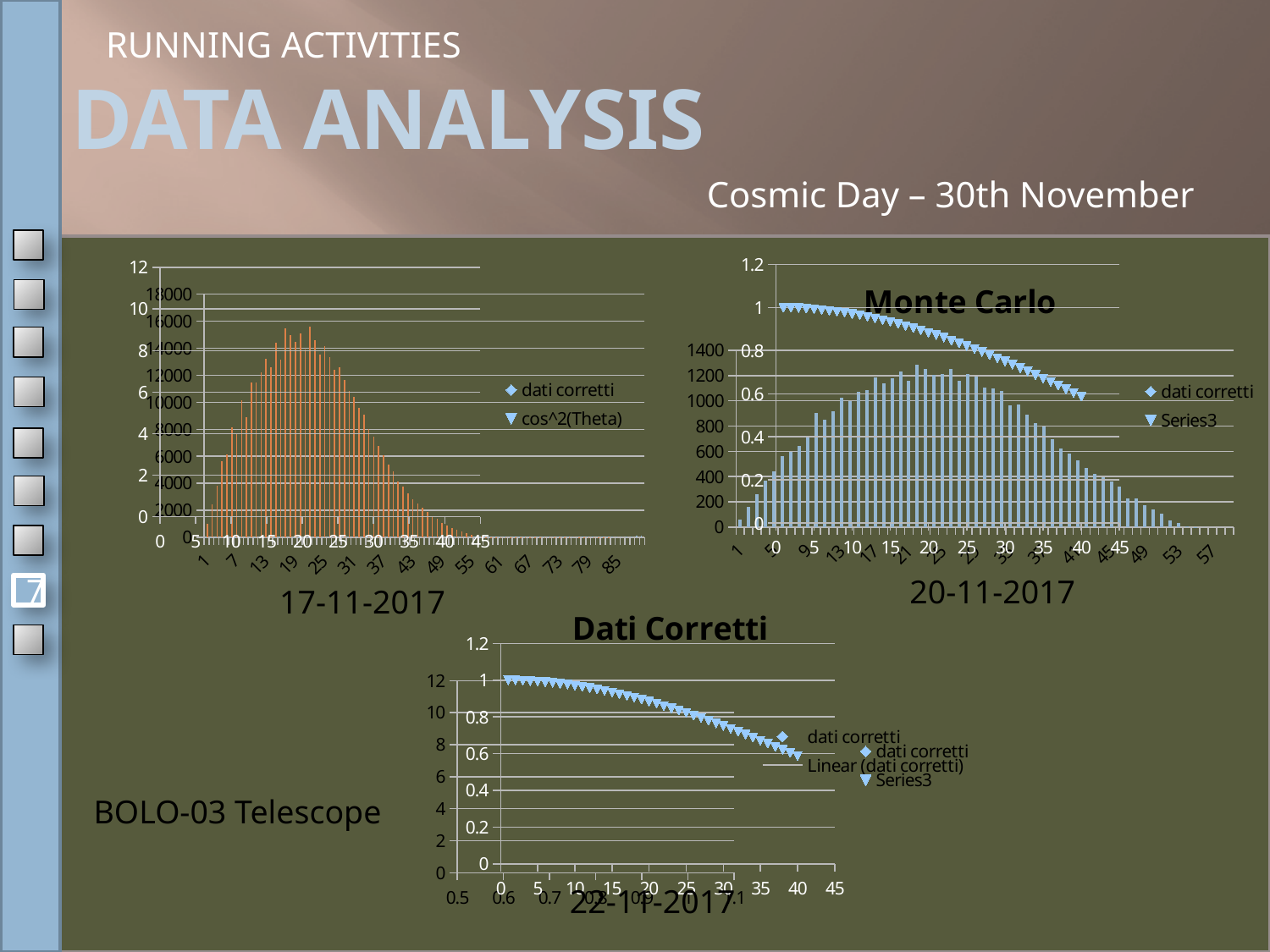
In the Dati Corretti chart, do the plotted dati corretti values rise or fall as x increases from 0 to 40? fall In the Monte Carlo chart, do the plotted dati corretti points rise or fall as x increases from 0 to 40? fall In the chart at the top left of the slide (dated 17-11-2017), how many entries does the legend list? 2 What is the title of the chart at the bottom centre of the slide? Dati Corretti In the Monte Carlo chart, how many entries does the legend list? 2 In the Dati Corretti chart, is the dati corretti value at x = 40 greater or less than 0.8? less What kind of chart is the orange chart at the top left of the slide (dated 17-11-2017)? bar chart In the Monte Carlo chart, is the tallest blue bar greater or less than 1200? greater In the Dati Corretti chart, is the dati corretti value at x = 0 greater or less than 0.8? greater What is the title of the chart at the top right of the slide? Monte Carlo